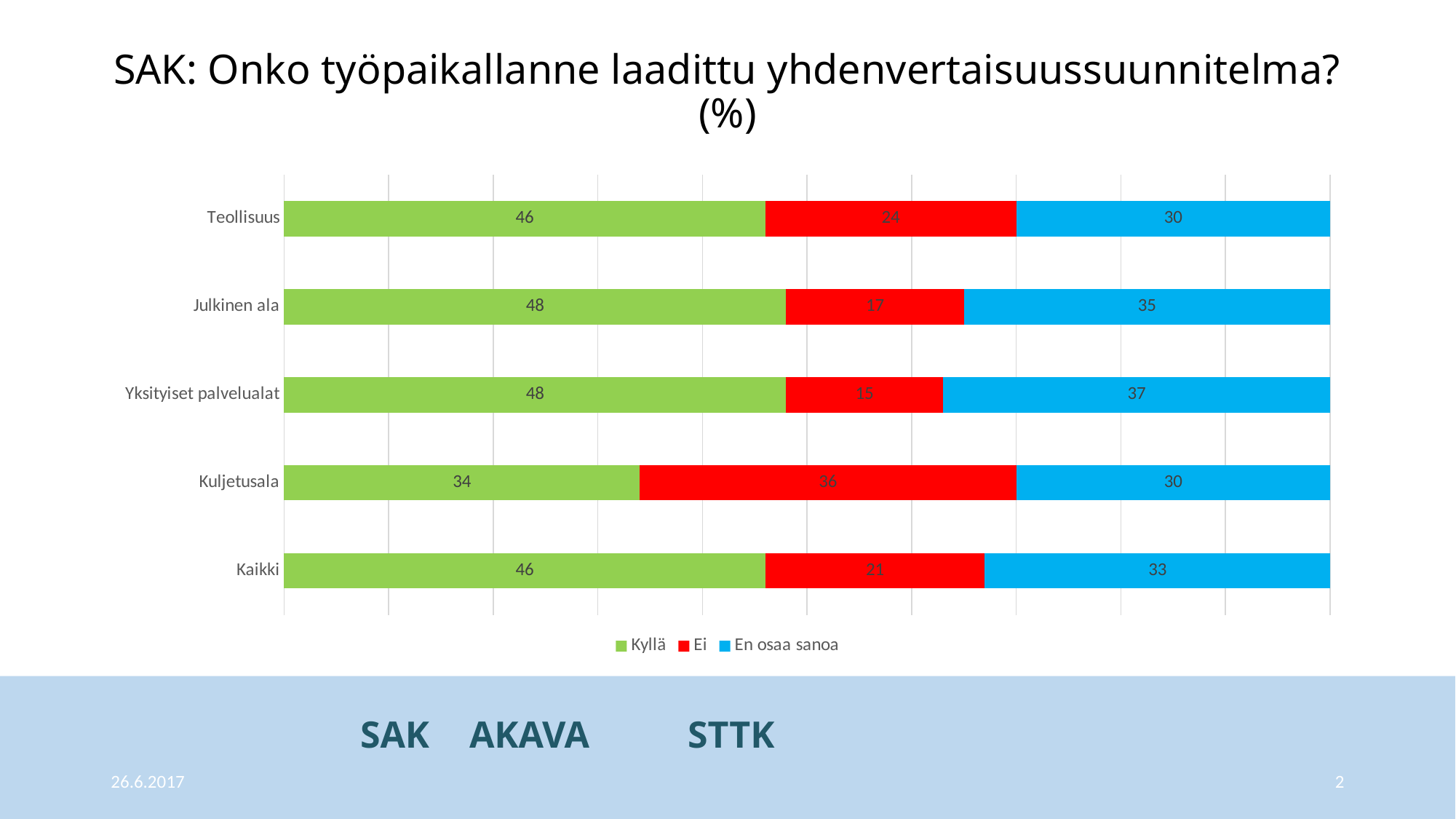
What is the "En osaa sanoa" value for Yksityiset palvelualat? 37 What is the total of the stacked bar for Kuljetusala? 100 What is the "Ei" value for Kuljetusala? 36 What is the "Ei" value for Kaikki? 21 How many categories are shown on the y axis? 5 What kind of chart is shown on the slide? Stacked bar chart How many series does the legend list? 3 What is the difference between the "En osaa sanoa" values for Julkinen ala and Teollisuus? 5 Which category has the lowest "Kyllä" value? Kuljetusala Which is larger: the "Ei" value for Teollisuus or the "Ei" value for Julkinen ala? Teollisuus Which category has the highest "Ei" value? Kuljetusala What is the "Kyllä" value for Teollisuus? 46